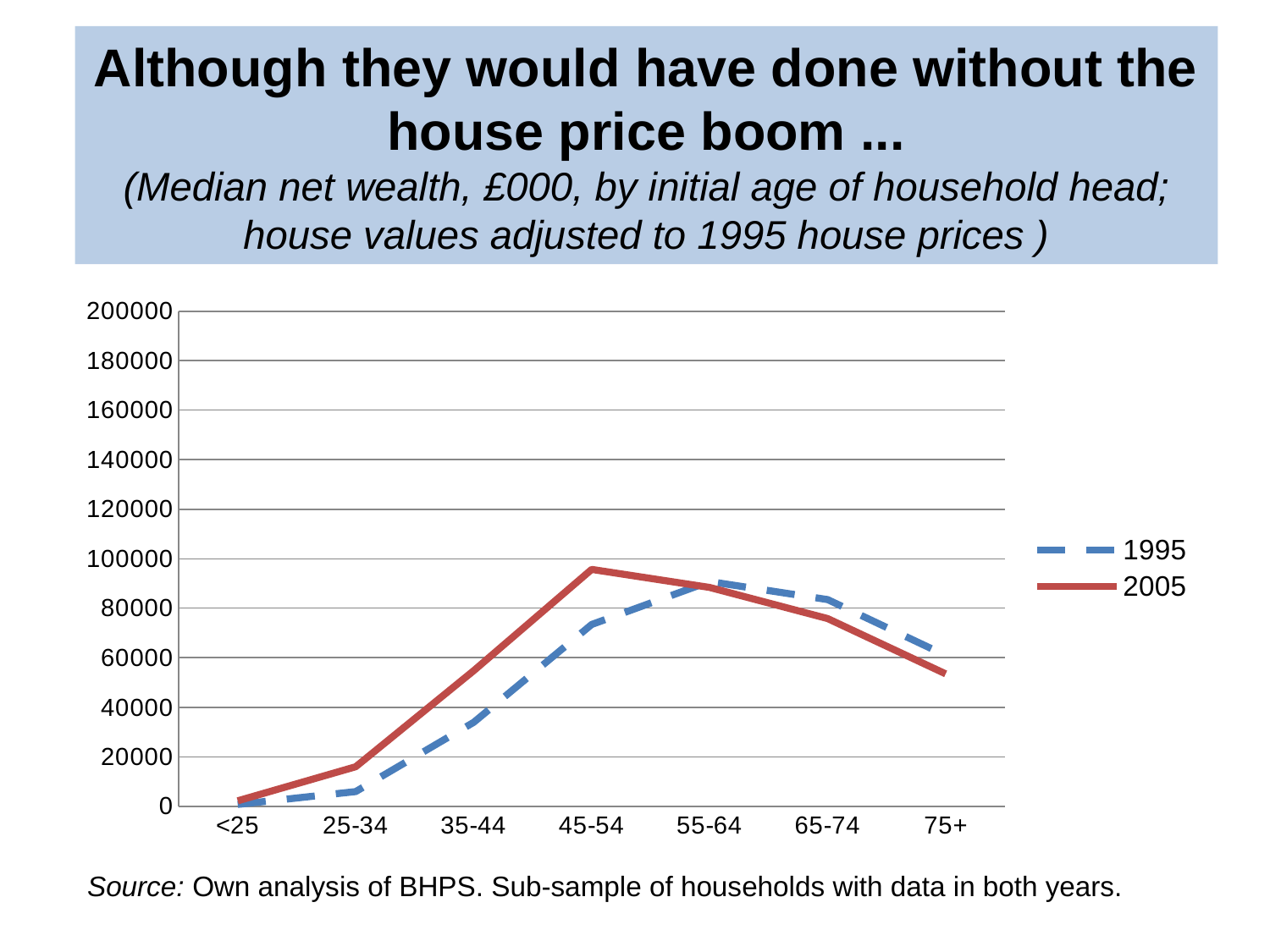
Which age group has the highest value for the 2005 series? 45-54 How many series does the legend list? 2 For the 75+ age group, which series has the larger value, 1995 or 2005? 1995 How many age groups are shown on the x axis? 7 For the 45-54 age group, which series has the larger value, 1995 or 2005? 2005 Is the 2005 value for the 25-34 age group greater or less than 20000? less What kind of chart is shown on the slide? line chart Does the 2005 series rise or fall from the 45-54 age group to the 75+ age group? fall Is the 2005 value for the 45-54 age group greater or less than 80000? greater Is the 2005 value for the 75+ age group greater or less than 60000? less Which age group has the lowest value for the 1995 series? <25